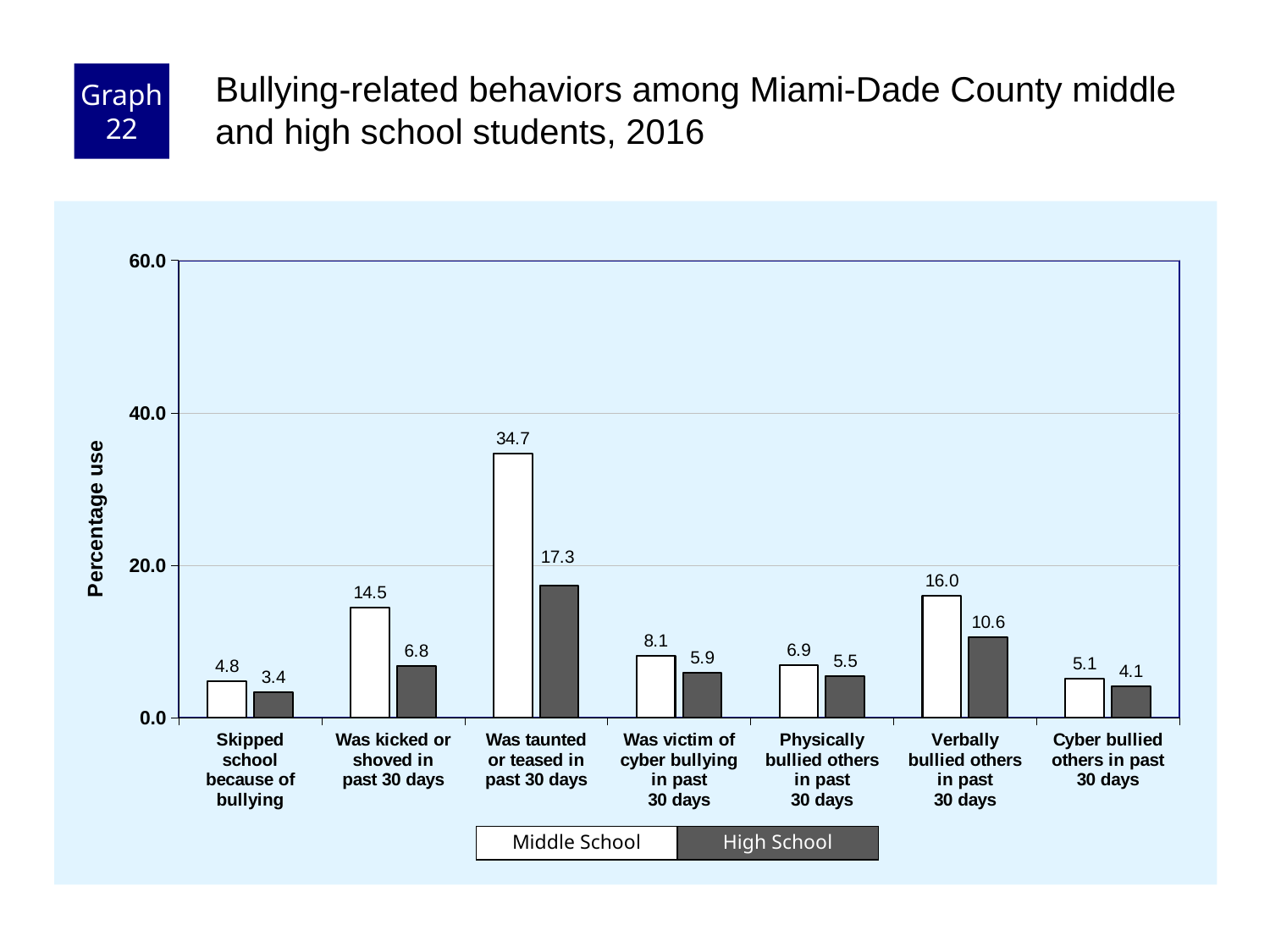
What kind of chart is shown on the slide? bar chart What is the High School value for 'Skipped school because of bullying'? 3.4 Which category has the highest Middle School value? Was taunted or teased in past 30 days Which category has the lowest High School value? Skipped school because of bullying What is the difference between the Middle School and High School values for 'Was taunted or teased in past 30 days'? 17.4 How many series does the legend list? 2 Which is larger: the Middle School value for 'Was kicked or shoved in past 30 days' or the Middle School value for 'Verbally bullied others in past 30 days'? Verbally bullied others in past 30 days What is the label of the y axis? Percentage use What is the Middle School value for 'Was taunted or teased in past 30 days'? 34.7 Is the Middle School value for 'Was taunted or teased in past 30 days' greater or less than 40.0? less What is the High School value for 'Verbally bullied others in past 30 days'? 10.6 How many categories are shown on the x axis? 7